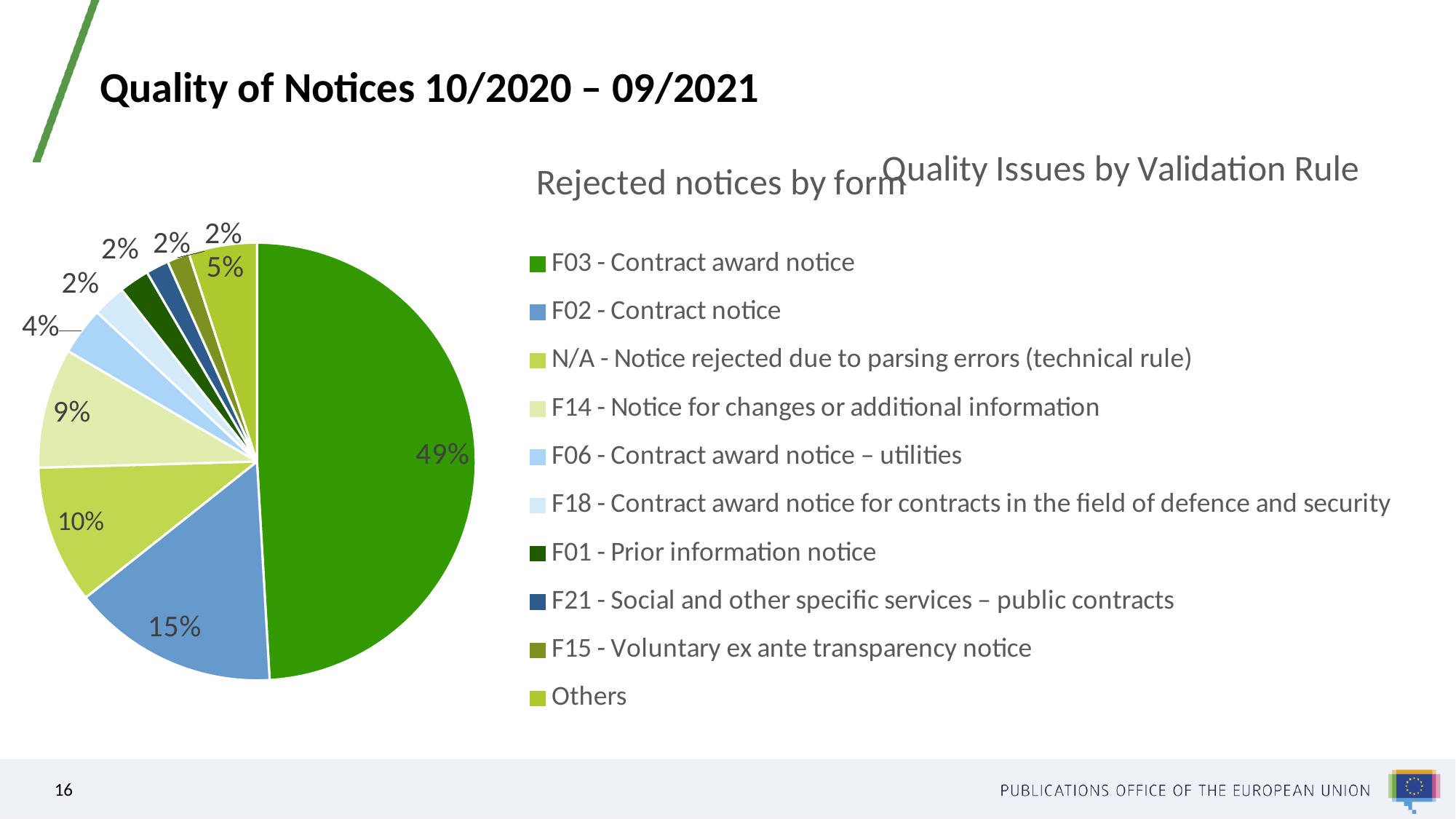
What share of rejected notices is F14 - Notice for changes or additional information? 9% What share of rejected notices is F02 - Contract notice? 15% What is the difference in share between F03 - Contract award notice and F02 - Contract notice? 34% How many entries does the legend of the pie chart list? 10 What share of rejected notices is N/A - Notice rejected due to parsing errors (technical rule)? 10% Which has a larger share of rejected notices, F14 - Notice for changes or additional information or F06 - Contract award notice – utilities? F14 - Notice for changes or additional information What share of rejected notices is F06 - Contract award notice – utilities? 4% What kind of chart is shown on the slide? pie chart Which form accounts for the largest share of rejected notices? F03 - Contract award notice What is the title of the pie chart? Rejected notices by form What share of rejected notices falls under Others? 5% What share of rejected notices is F03 - Contract award notice? 49%